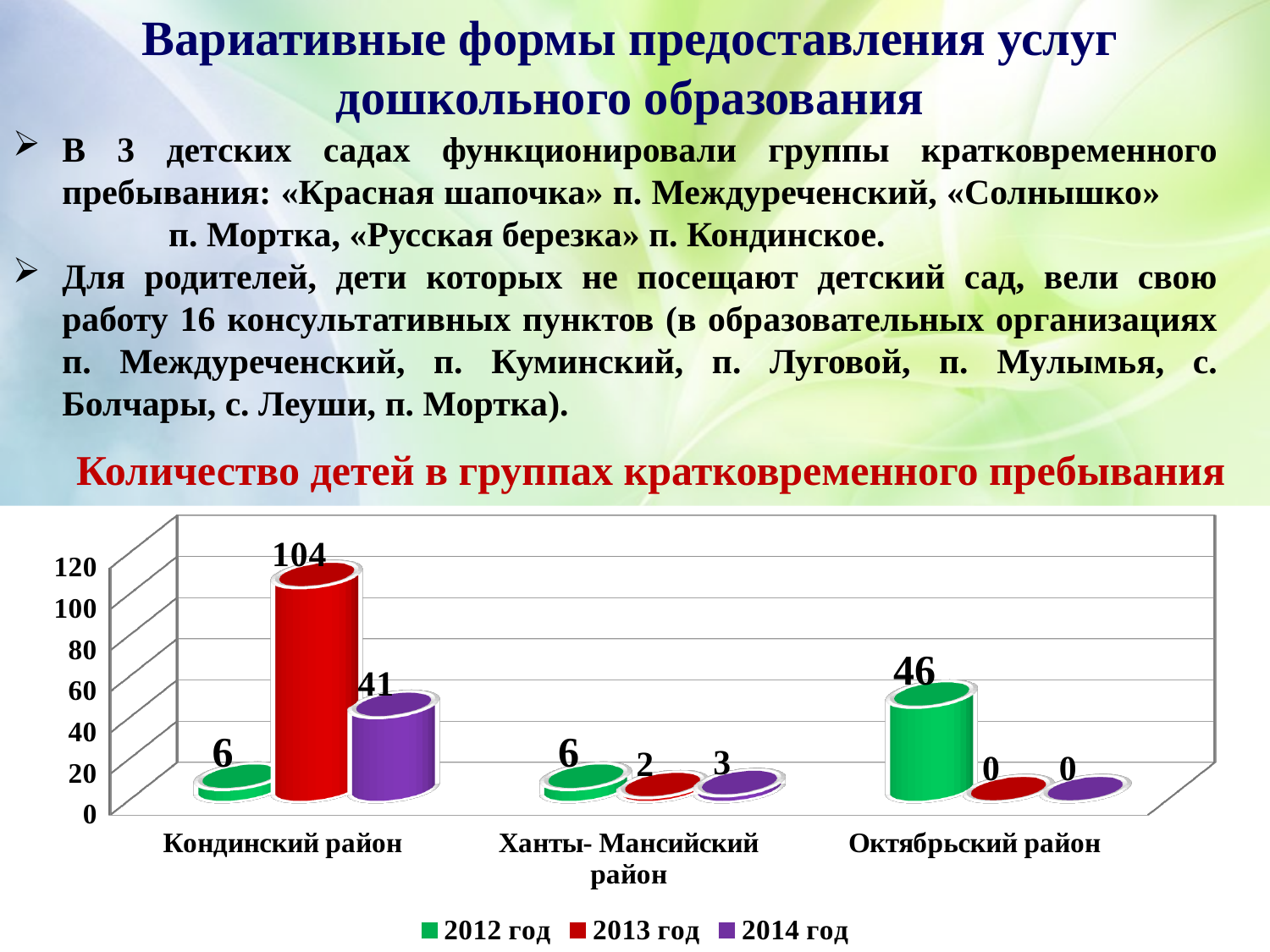
What is the value for 2012 год in Октябрьский район? 46 What kind of chart is shown on the slide? Bar chart Which category has the lowest value for 2012 год? Кондинский район and Ханты-Мансийский район (both 6) What is the value for 2014 год in Кондинский район? 41 What is the value for 2013 год in Ханты-Мансийский район? 2 What is the difference between the 2013 год and 2014 год values in Кондинский район? 63 How many categories are shown on the x axis? 3 How many series does the legend list? 3 What is the title of the chart? Количество детей в группах кратковременного пребывания Which category has the highest value for 2013 год? Кондинский район What is the value for 2013 год in Кондинский район? 104 Which is larger: the 2012 год value in Октябрьский район or the 2014 год value in Кондинский район? 2012 год in Октябрьский район